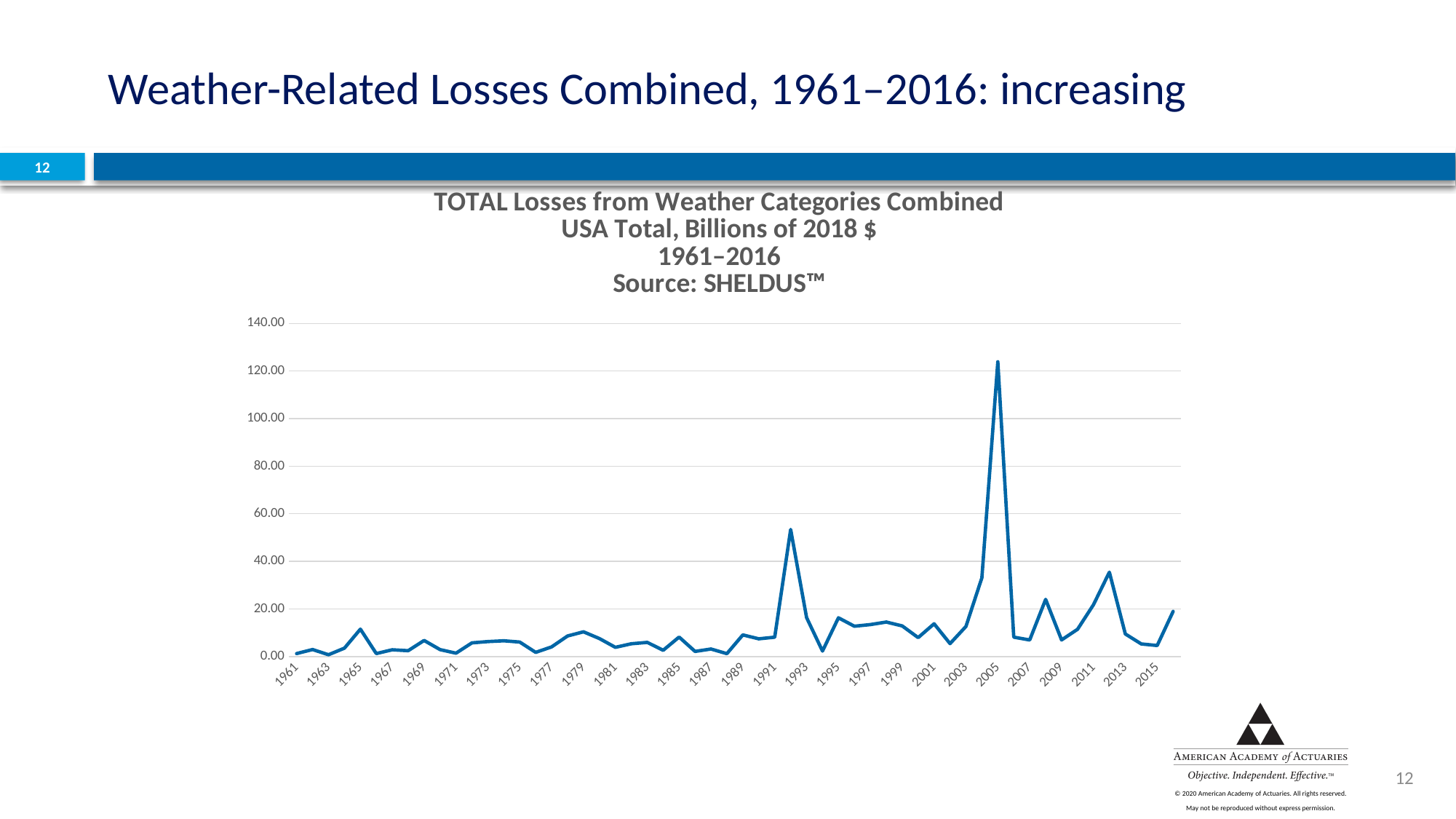
Is the value for 1992 greater or less than 60? less In which year do total weather-related losses reach their highest value? 2005 Which year has the larger value, 1992 or 2012? 1992 Is the value for 1992 greater or less than 40? greater Is the value for 2005 greater or less than 100? greater What is the data source named in the chart title? SHELDUS™ Which year has the larger value, 2005 or 1992? 2005 What kind of chart is shown on the slide? line chart According to the slide title, are weather-related losses increasing or decreasing over 1961–2016? increasing